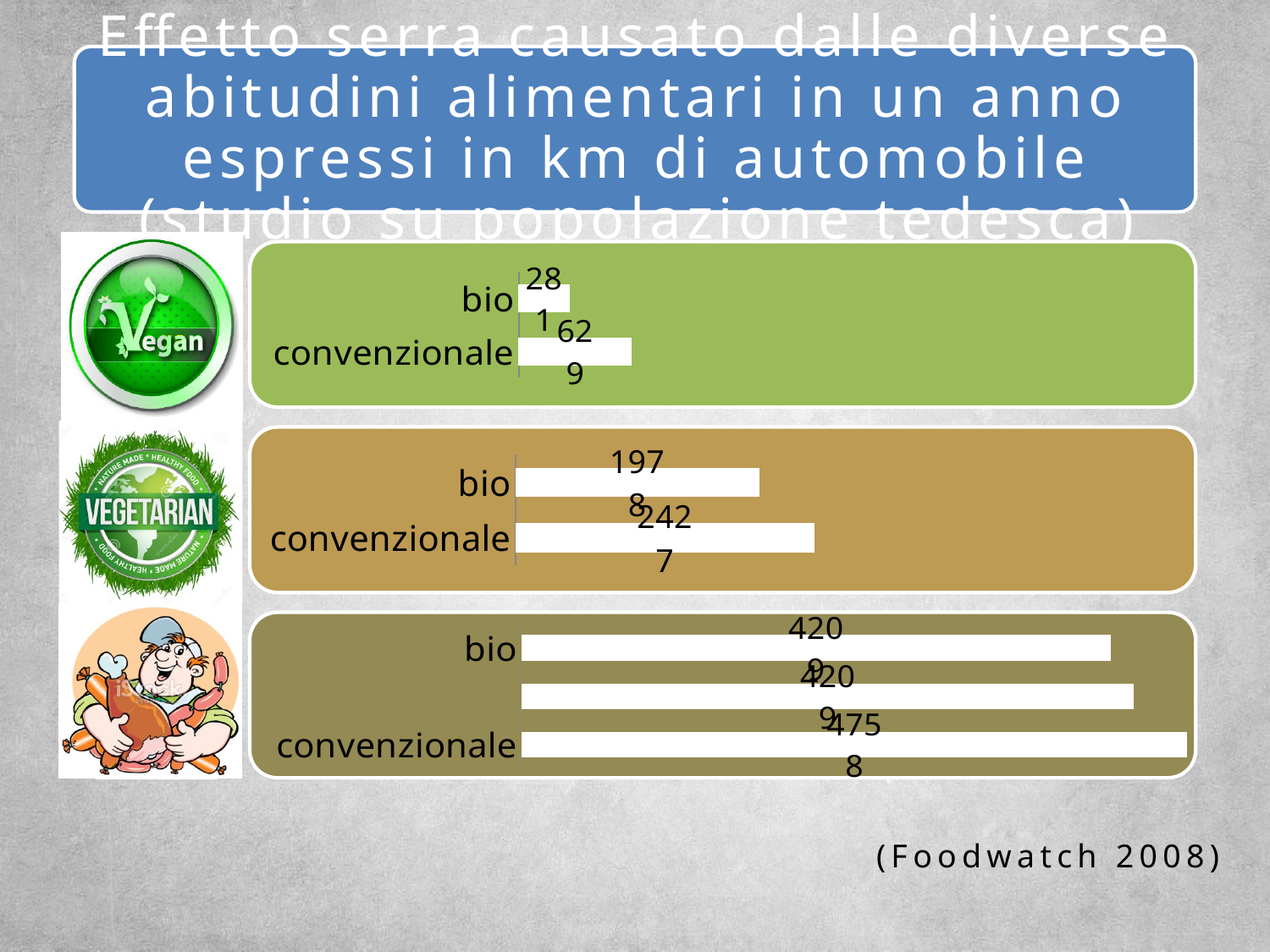
What are the two category labels shown in the middle (vegetarian) chart? bio and convenzionale In the bottom (meat) chart, which labelled category has the longest bar? convenzionale How many bars are shown in the top (vegan) chart? 2 In the top (vegan) chart, which category has the longer bar, bio or convenzionale? convenzionale In the middle (vegetarian) chart, which category has the longer bar, bio or convenzionale? convenzionale How many bars are shown in the bottom (meat) chart? 3 What is the source cited at the bottom of the slide? Foodwatch 2008 What kind of chart is the top (vegan) chart? bar chart Which of the three charts on the slide has the shortest bars overall? the top (vegan) chart How many bars are shown in the middle (vegetarian) chart? 2